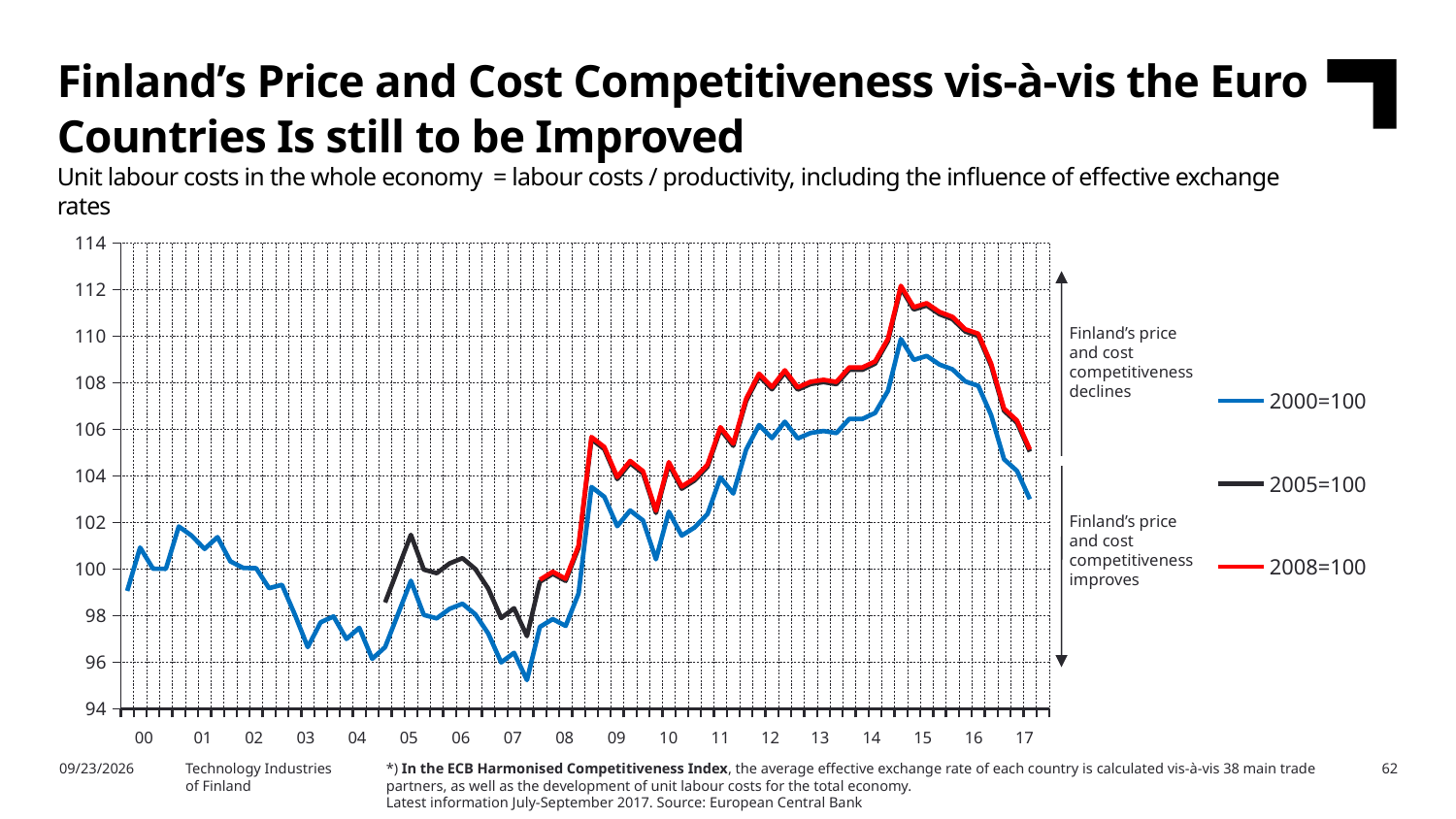
Is the value of the 2000=100 series at the end of 2017 greater or less than 102? greater What colour is the 2008=100 series drawn in? red Around 2015, which series is higher, 2008=100 or 2000=100? 2008=100 Is the lowest value of the 2000=100 series (around 2007) greater or less than 98? less Is the peak value of the 2008=100 series greater or less than 110? greater What are the three series named in the legend? 2000=100, 2005=100, 2008=100 How many series does the legend list? 3 What kind of chart is shown on the slide? line chart Which series reaches the highest value on the chart? 2008=100 How many years are labelled on the x axis? 18 From 2008 to 2009, does the 2000=100 series rise or fall? rise From 2015 to 2017, do the series rise or fall? fall